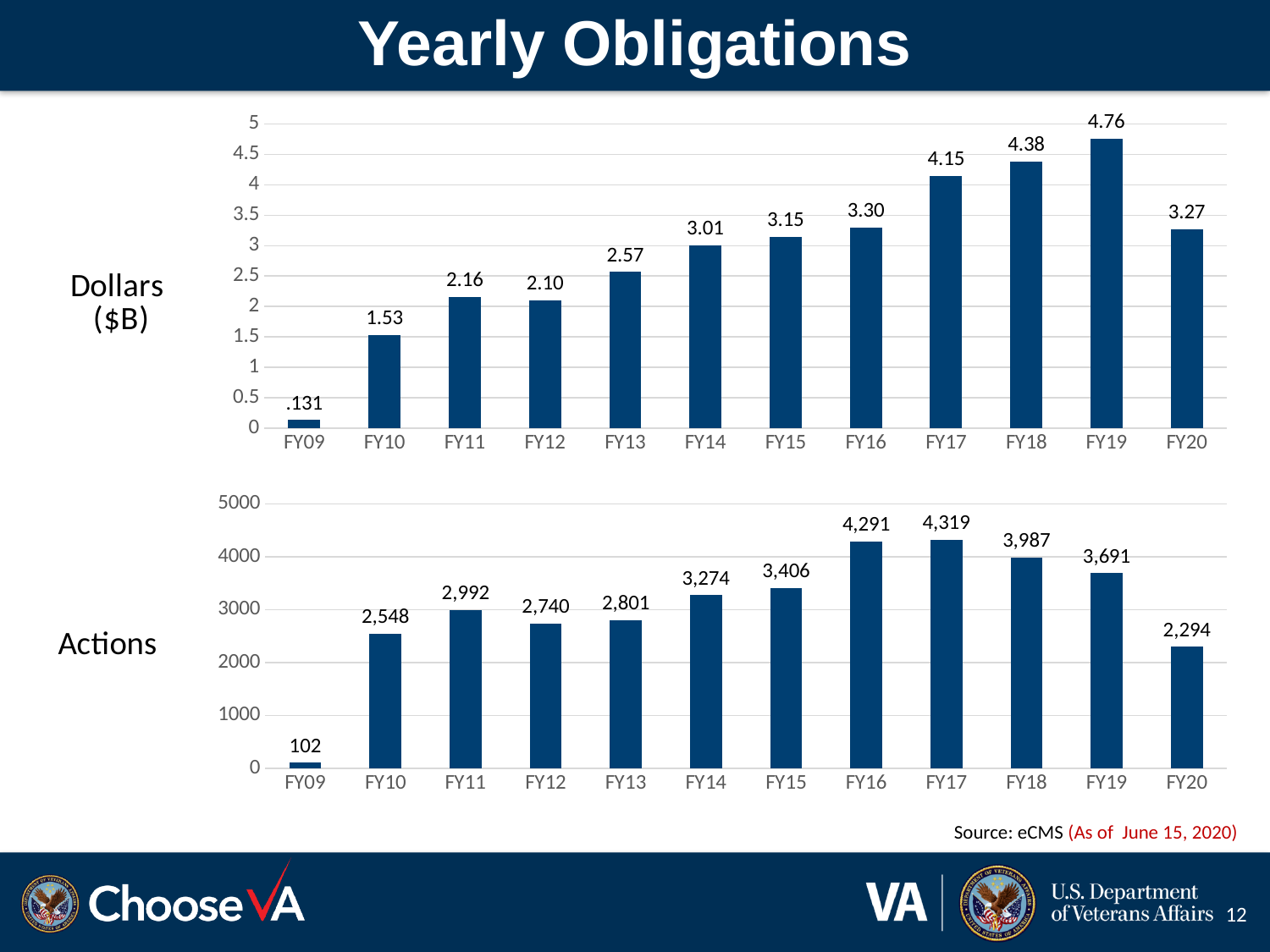
In the Dollars ($B) chart, which fiscal year has the lowest value? FY09 In the Dollars ($B) chart, what is the difference between FY19 and FY18? 0.38 In the Dollars ($B) chart, what is the value for FY20? 3.27 In the Actions chart, what is the difference between FY17 and FY20? 2,025 How many fiscal years are shown in the Actions chart? 12 In the Actions chart, what is the value for FY16? 4,291 What kind of chart is the Dollars ($B) chart? Bar chart In the Dollars ($B) chart, is the value for FY17 greater or less than 4? greater In the Dollars ($B) chart, what is the value for FY19? 4.76 In the Actions chart, which is larger, FY11 or FY12? FY11 In the Actions chart, which fiscal year has the highest value? FY17 In the Dollars ($B) chart, do the values rise or fall from FY16 to FY19? Rise